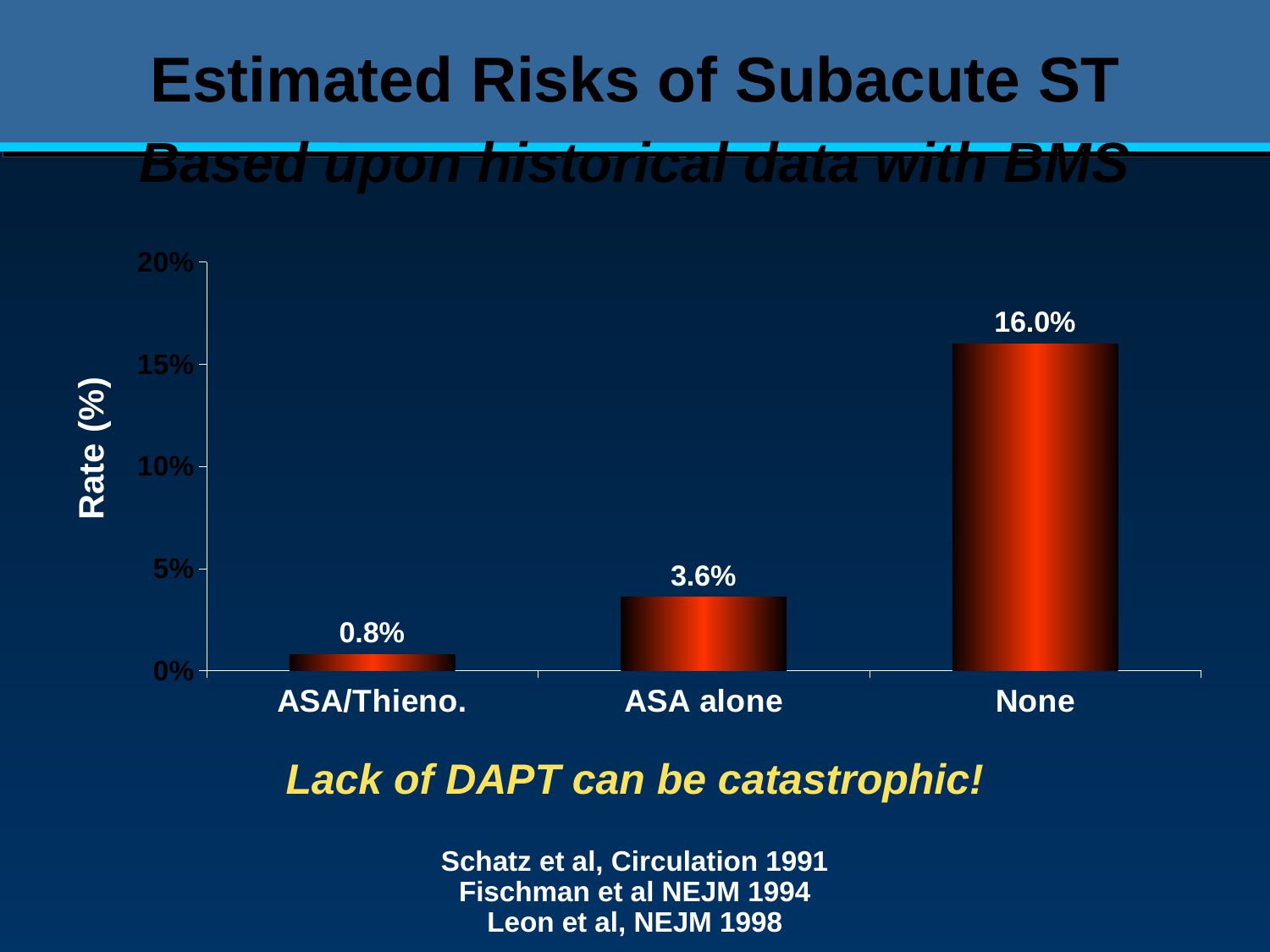
What is the rate for None? 16.0% Is the value for None greater or less than 15%? greater What kind of chart is shown on the slide? bar chart What is the difference between the rate for None and the rate for ASA alone? 12.4% How many categories are shown on the x axis? 3 Which category has the lowest rate? ASA/Thieno. Which has a higher rate, ASA alone or ASA/Thieno.? ASA alone What is the rate for ASA alone? 3.6% What is the label of the y axis? Rate (%) What is the rate for ASA/Thieno.? 0.8% Which category has the highest rate? None What is the difference between the rate for ASA alone and the rate for ASA/Thieno.? 2.8%